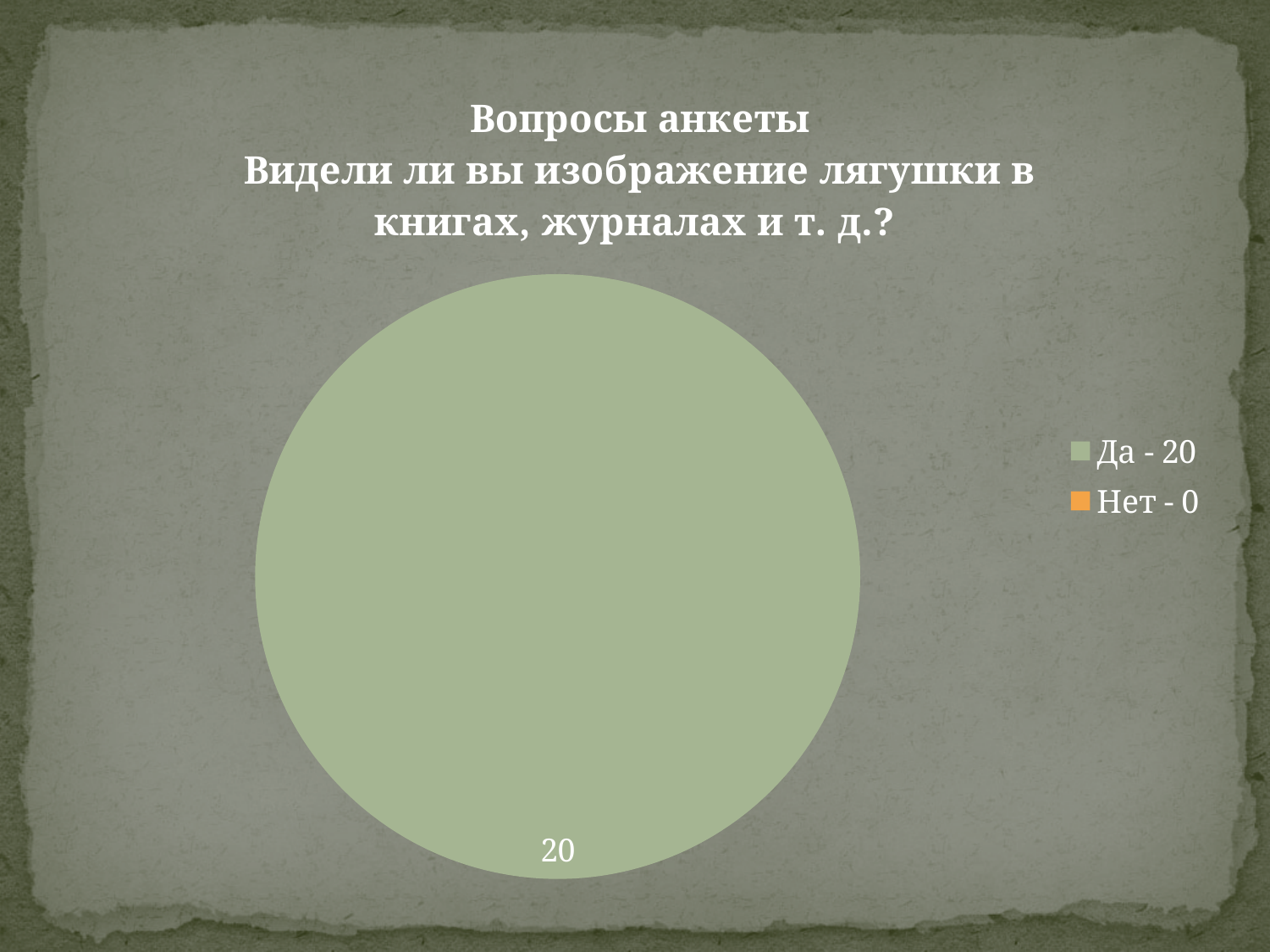
What kind of chart is shown on the slide? pie chart Which is larger, the value for "Да" or the value for "Нет"? Да How many entries does the legend list? 2 What value is shown for the "Да" category? 20 What data label is printed on the pie chart? 20 What is the difference between the values for "Да" and "Нет"? 20 What is the total of all values in the pie chart? 20 What share of the pie does the "Да" slice take? 100% What colour is the "Да" slice in the pie chart? green What value is shown for the "Нет" category? 0 Which category has the smallest value? Нет Which category has the largest share of the pie? Да